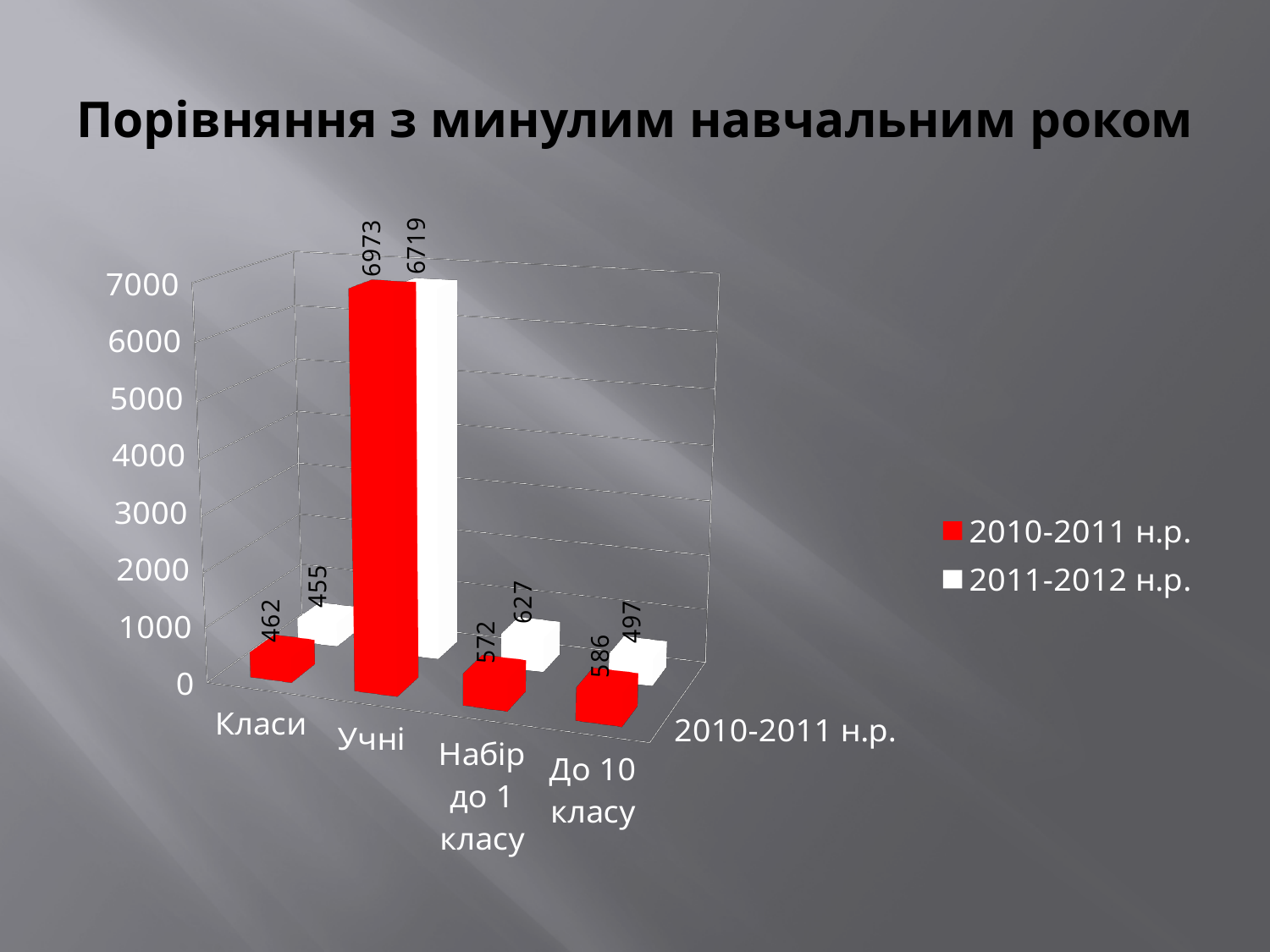
Which category has the highest value in the 2010-2011 н.р. series? Учні Which category has the lowest value in the 2011-2012 н.р. series? Класи What is the difference between the 2010-2011 н.р. and 2011-2012 н.р. values for Учні? 254 What is the value for Учні in the 2010-2011 н.р. series? 6973 What is the value for До 10 класу in the 2010-2011 н.р. series? 586 What is the value for Учні in the 2011-2012 н.р. series? 6719 What is the value for Набір до 1 класу in the 2011-2012 н.р. series? 627 For До 10 класу, which series has the larger value: 2010-2011 н.р. or 2011-2012 н.р.? 2010-2011 н.р. How many categories are shown on the x axis? 4 What is the value for Класи in the 2011-2012 н.р. series? 455 How many series does the legend list? 2 What type of chart is shown on the slide? Bar chart